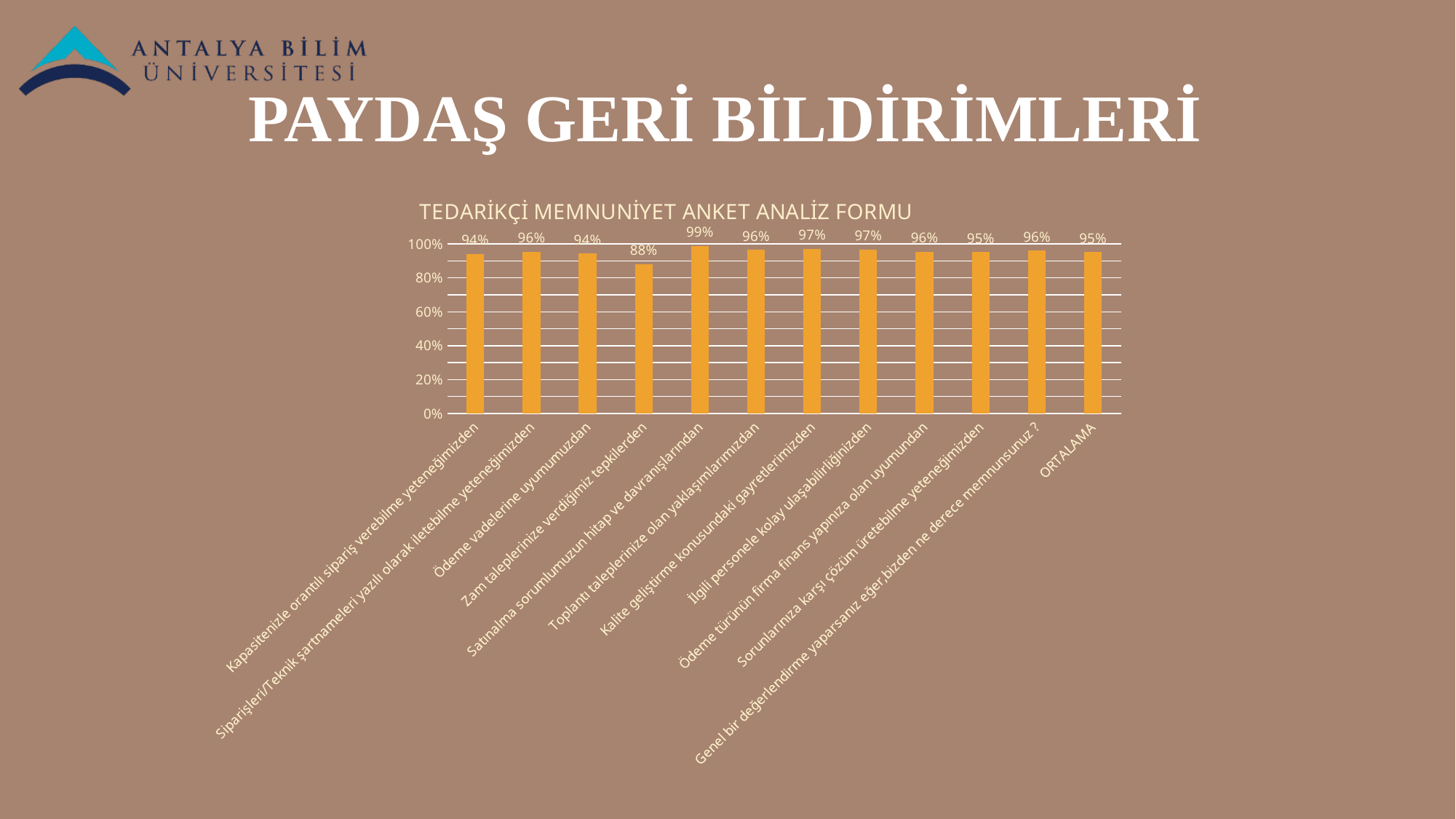
Which is larger: the value for "Kapasitenizle orantılı sipariş verebilme yeteneğimizden" or the value for "Siparişleri/Teknik şartnameleri yazılı olarak iletebilme yeteneğimizden"? Siparişleri/Teknik şartnameleri yazılı olarak iletebilme yeteneğimizden Which category has the highest value? Satınalma sorumlumuzun hitap ve davranışlarından Which category has the lowest value? Zam taleplerinize verdiğimiz tepkilerden What is the title of the chart? TEDARİKÇİ MEMNUNİYET ANKET ANALİZ FORMU What kind of chart is shown on the slide? Bar chart What is the value for "Zam taleplerinize verdiğimiz tepkilerden"? 88% What is the value for "Ödeme vadelerine uyumumuzdan"? 94% What is the difference between the highest value (99%) and the lowest value (88%)? 11% How many categories are shown on the x axis? 12 What is the value for "Kalite geliştirme konusundaki gayretlerimizden"? 97% What is the value for ORTALAMA? 95% What is the value for "Satınalma sorumlumuzun hitap ve davranışlarından"? 99%